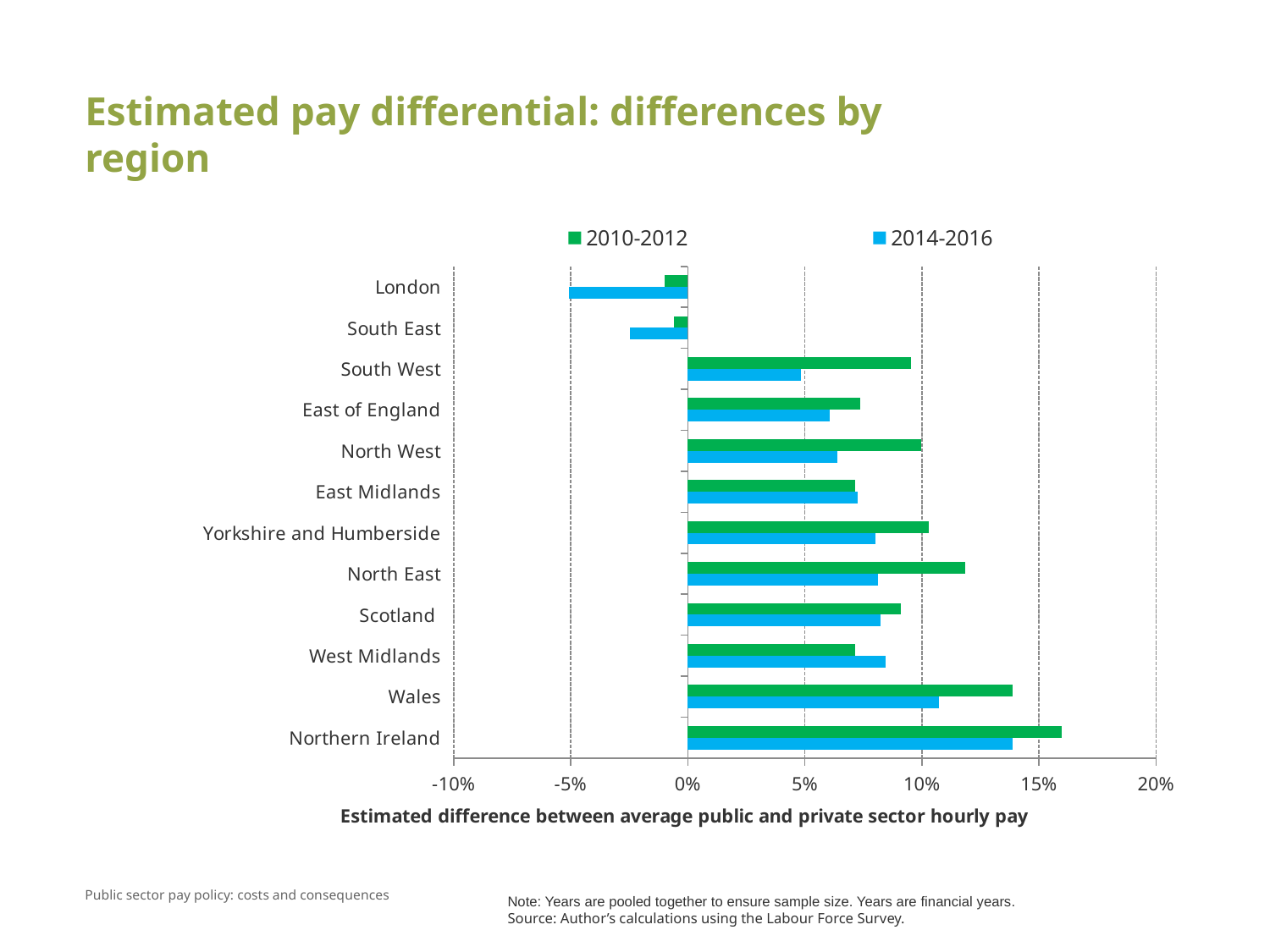
Which region has the highest value for 2010-2012? Northern Ireland What is the title of the horizontal axis? Estimated difference between average public and private sector hourly pay How many series does the legend list? 2 For Wales, which series has the larger value, 2010-2012 or 2014-2016? 2010-2012 Is the 2014-2016 value for London greater or less than 0%? less How many regions are shown on the chart? 12 Which region has the lowest value for 2014-2016? London Is the 2010-2012 value for Northern Ireland greater or less than 15%? greater What kind of chart is shown on the slide? Bar chart For West Midlands, which series has the larger value, 2010-2012 or 2014-2016? 2014-2016 Is the 2010-2012 value for North East greater or less than 10%? greater